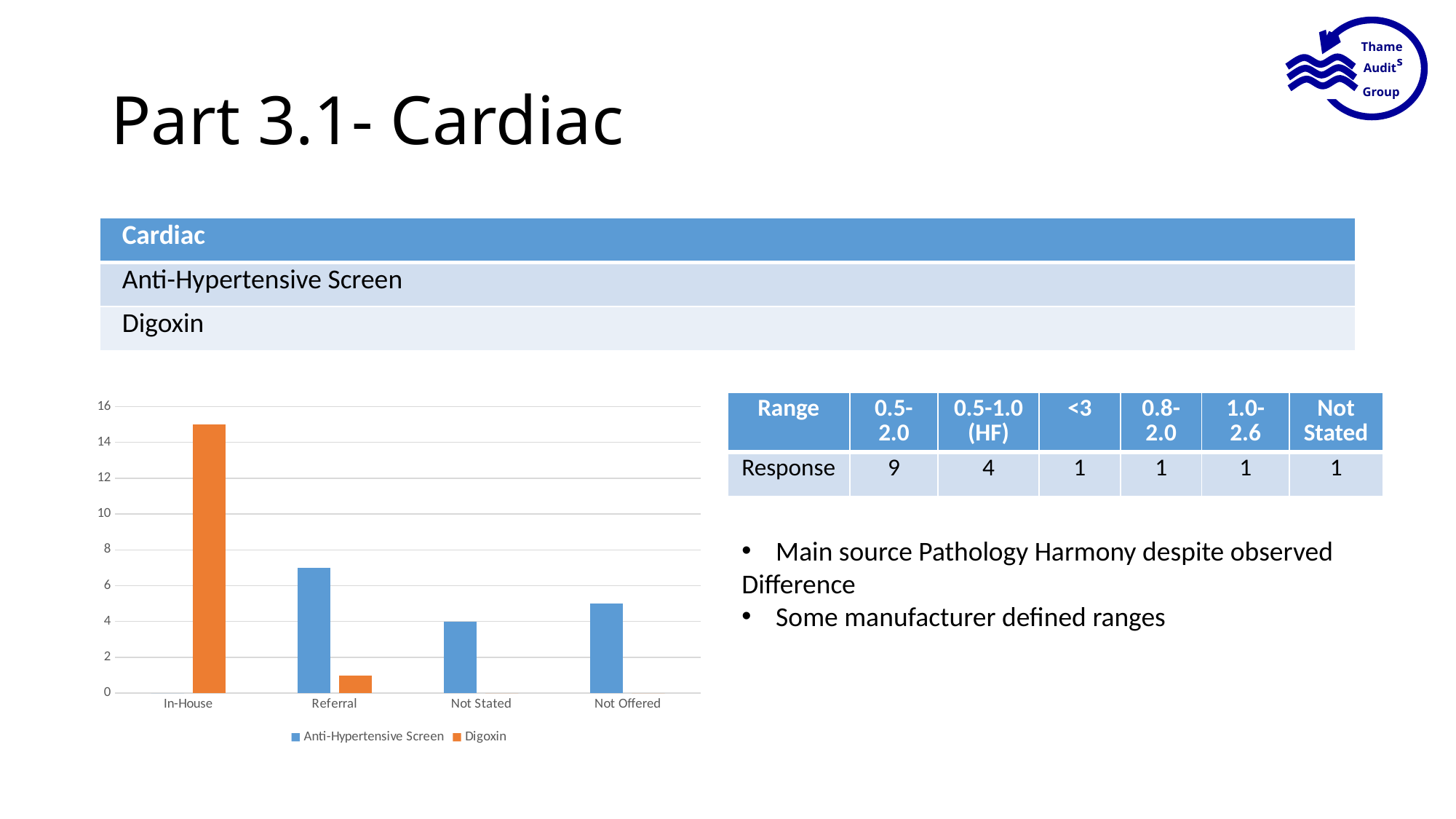
What kind of chart is shown on the slide? bar chart Is the Anti-Hypertensive Screen value for Referral greater or less than 6? greater Which category has the lowest Anti-Hypertensive Screen value? In-House Which category has the highest Digoxin value? In-House What colour are the Digoxin bars in the chart? orange How many categories are shown on the x axis of the chart? 4 Is the Digoxin value for Referral greater or less than 2? less In the Referral category, which series has the larger value, Anti-Hypertensive Screen or Digoxin? Anti-Hypertensive Screen What is the value for Anti-Hypertensive Screen in the Not Stated category? 4 Is the Digoxin value for In-House greater or less than 14? greater Which category has the highest Anti-Hypertensive Screen value? Referral How many series does the chart legend list? 2